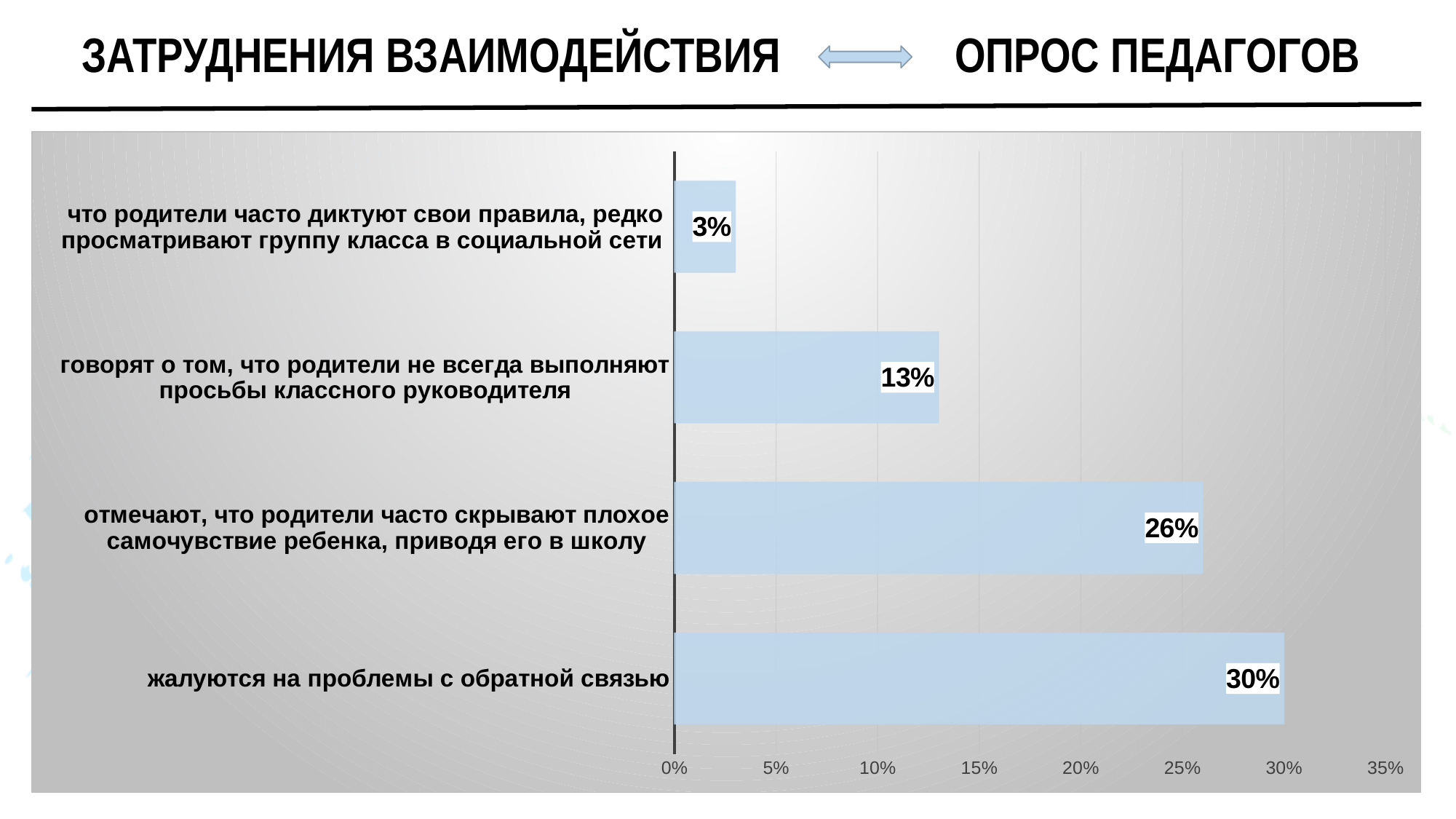
What is the maximum value shown on the horizontal axis? 35% Which category has the highest value? жалуются на проблемы с обратной связью What percentage of teachers complain about problems with feedback (жалуются на проблемы с обратной связью)? 30% How many categories are shown in the chart? 4 Which category has the lowest value? что родители часто диктуют свои правила, редко просматривают группу класса в социальной сети What kind of chart is shown on the slide? bar chart What is the value for the category about parents often dictating their own rules and rarely viewing the class group on social networks? 3% What is the difference between the value for 'жалуются на проблемы с обратной связью' and the value for 'говорят о том, что родители не всегда выполняют просьбы классного руководителя'? 17% What is the value for 'говорят о том, что родители не всегда выполняют просьбы классного руководителя'? 13% What is the difference between the values for 'отмечают, что родители часто скрывают плохое самочувствие ребенка' and 'что родители часто диктуют свои правила'? 23% What is the value for the category 'отмечают, что родители часто скрывают плохое самочувствие ребенка, приводя его в школу'? 26% Which is larger: the value for 'отмечают, что родители часто скрывают плохое самочувствие ребенка' or the value for 'говорят о том, что родители не всегда выполняют просьбы классного руководителя'? отмечают, что родители часто скрывают плохое самочувствие ребенка